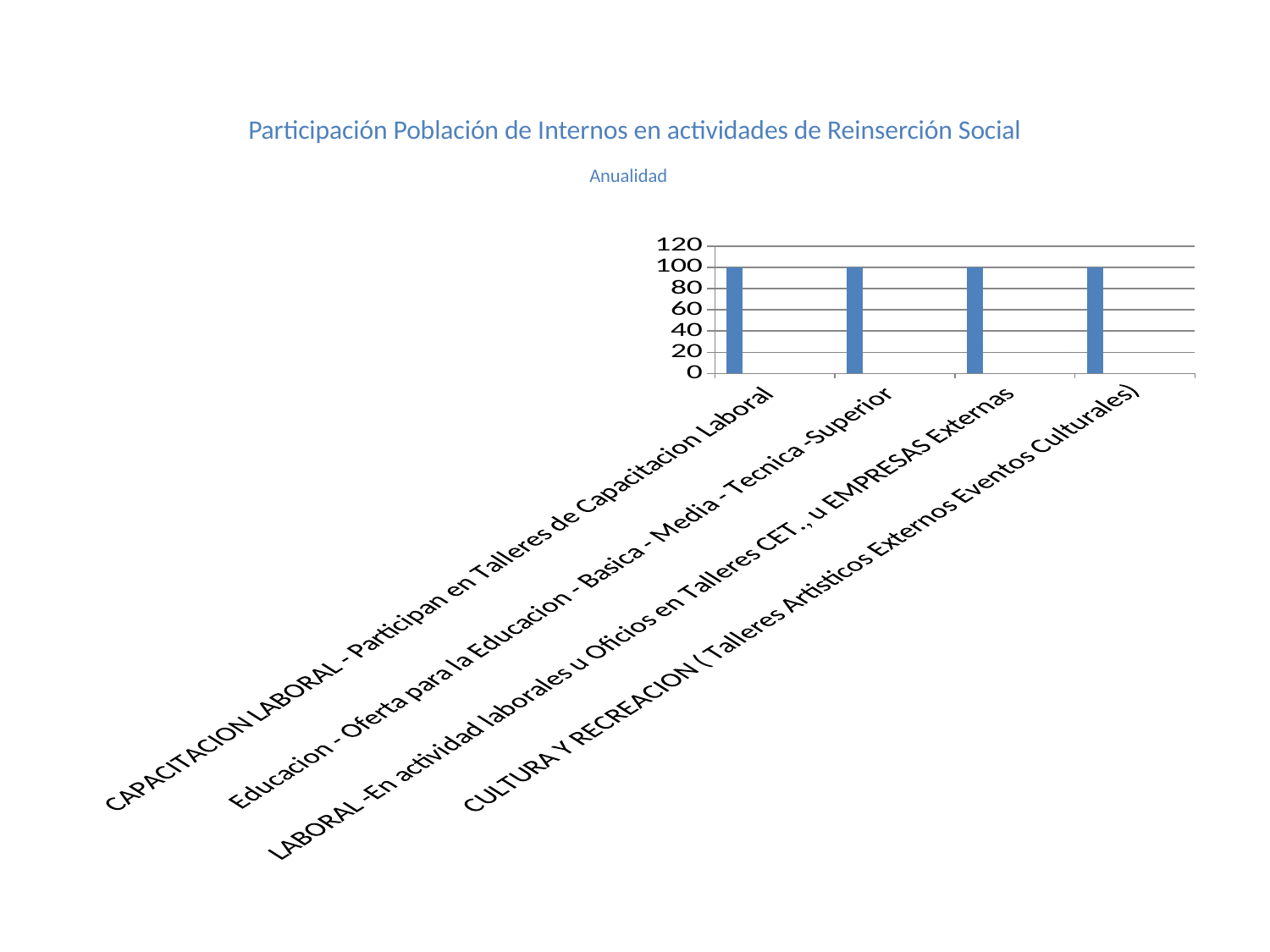
Do the values rise, fall, or stay the same across the categories from left to right? stay the same How many categories are plotted on the x axis of the chart? 4 Is the value for 'CULTURA Y RECREACION ( Talleres Artisticos Externos Eventos Culturales)' greater or less than 80? greater Is the value for 'Educacion - Oferta para la Educacion - Basica - Media - Tecnica -Superior' greater or less than 120? less What kind of chart is shown on the slide? bar chart What is the value for 'CULTURA Y RECREACION ( Talleres Artisticos Externos Eventos Culturales)'? 100 What is the title of the chart? Participación Población de Internos en actividades de Reinserción Social What is the difference between the value for 'CAPACITACION LABORAL - Participan en Talleres de Capacitacion Laboral' and the value for 'LABORAL -En actividad laborales u Oficios en Talleres CET., u EMPRESAS Externas'? 0 What is the value for 'CAPACITACION LABORAL - Participan en Talleres de Capacitacion Laboral'? 100 What subtitle appears below the chart title? Anualidad What is the value for 'LABORAL -En actividad laborales u Oficios en Talleres CET., u EMPRESAS Externas'? 100 What is the value for 'Educacion - Oferta para la Educacion - Basica - Media - Tecnica -Superior'? 100